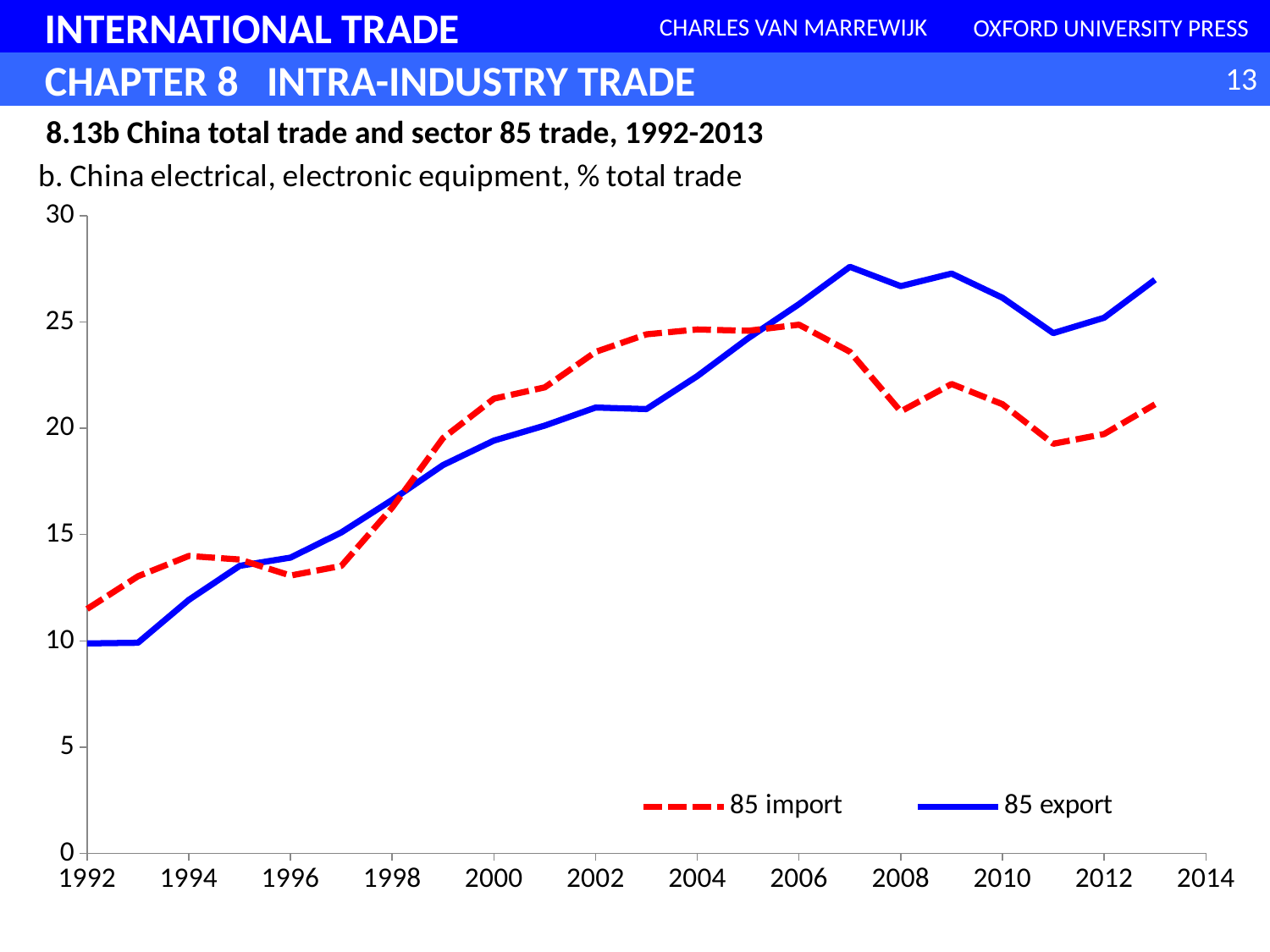
What are the two series named in the legend? 85 import and 85 export What kind of chart is shown on the slide? line chart Is the value for 85 import in 1992 greater or less than 10? greater Is the value for 85 export in 2013 greater or less than 25? greater How many series does the legend list? 2 Does the 85 import line generally rise or fall between 2006 and 2011? fall Is the value for 85 export in 2007 greater or less than 25? greater Which series is drawn as a red dashed line? 85 import In 2002, which series has the higher value, 85 import or 85 export? 85 import In 2013, which series has the higher value, 85 import or 85 export? 85 export Does the 85 export line generally rise or fall between 1992 and 2007? rise